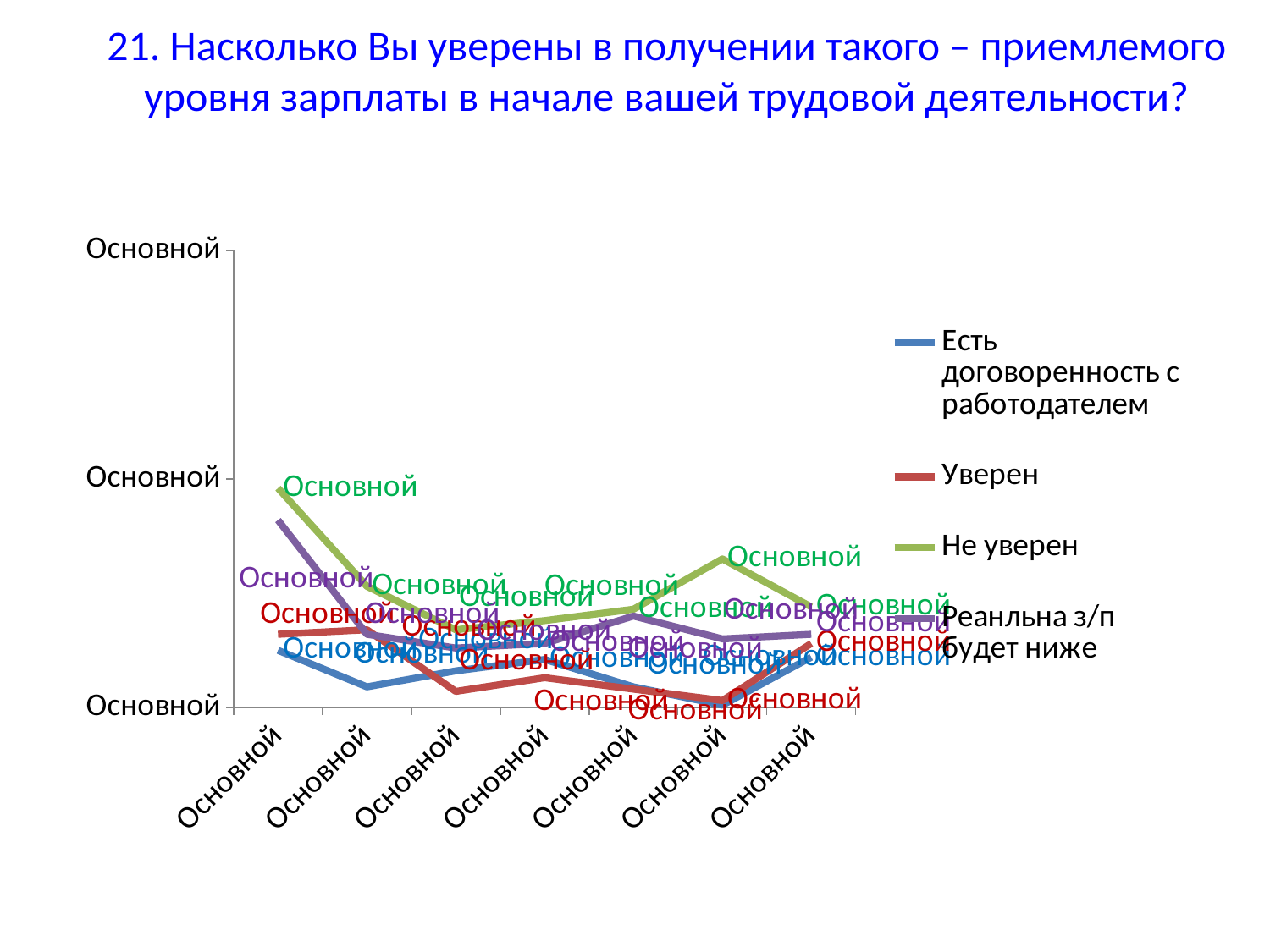
Which series is shown in green in the legend? Не уверен At the leftmost point on the x axis, which is larger: the value for "Не уверен" or the value for "Уверен"? Не уверен Which series is shown in blue in the legend? Есть договоренность с работодателем At the leftmost point on the x axis, which series has the highest value? Не уверен How many points are plotted along the x axis for each series? 7 Does the "Не уверен" line rise or fall between the fifth and sixth points on the x axis? rise What kind of chart is shown on the slide? line chart How many series does the legend list? 4 At the leftmost point on the x axis, which series has the lowest value? Есть договоренность с работодателем Does the "Не уверен" line rise or fall between the first and second points on the x axis? fall